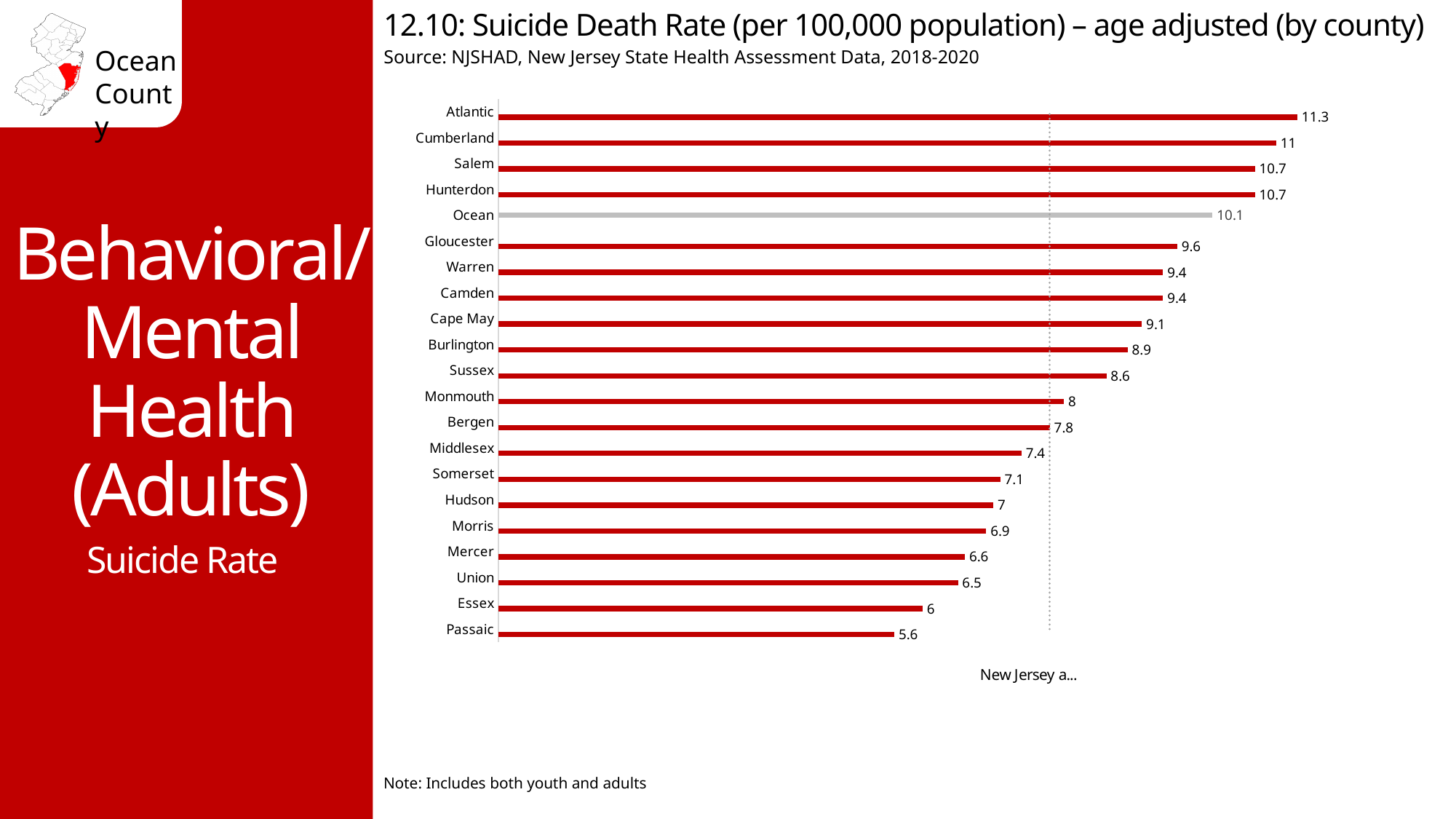
What is the suicide death rate for Ocean County? 10.1 What type of chart is used on this slide? Bar chart Which county's bar is shown in gray instead of red? Ocean Which county has the highest suicide death rate? Atlantic What is the difference between the suicide death rates of Ocean and Monmouth counties? 2.1 What is the suicide death rate for Passaic County? 5.6 Do the values rise or fall going from the top bar to the bottom bar? Fall Which county has the lowest suicide death rate? Passaic Which county has a higher suicide death rate, Gloucester or Bergen? Gloucester How many counties are shown in the chart? 21 What is the difference between the suicide death rates of Atlantic and Passaic counties? 5.7 What is the suicide death rate for Atlantic County? 11.3